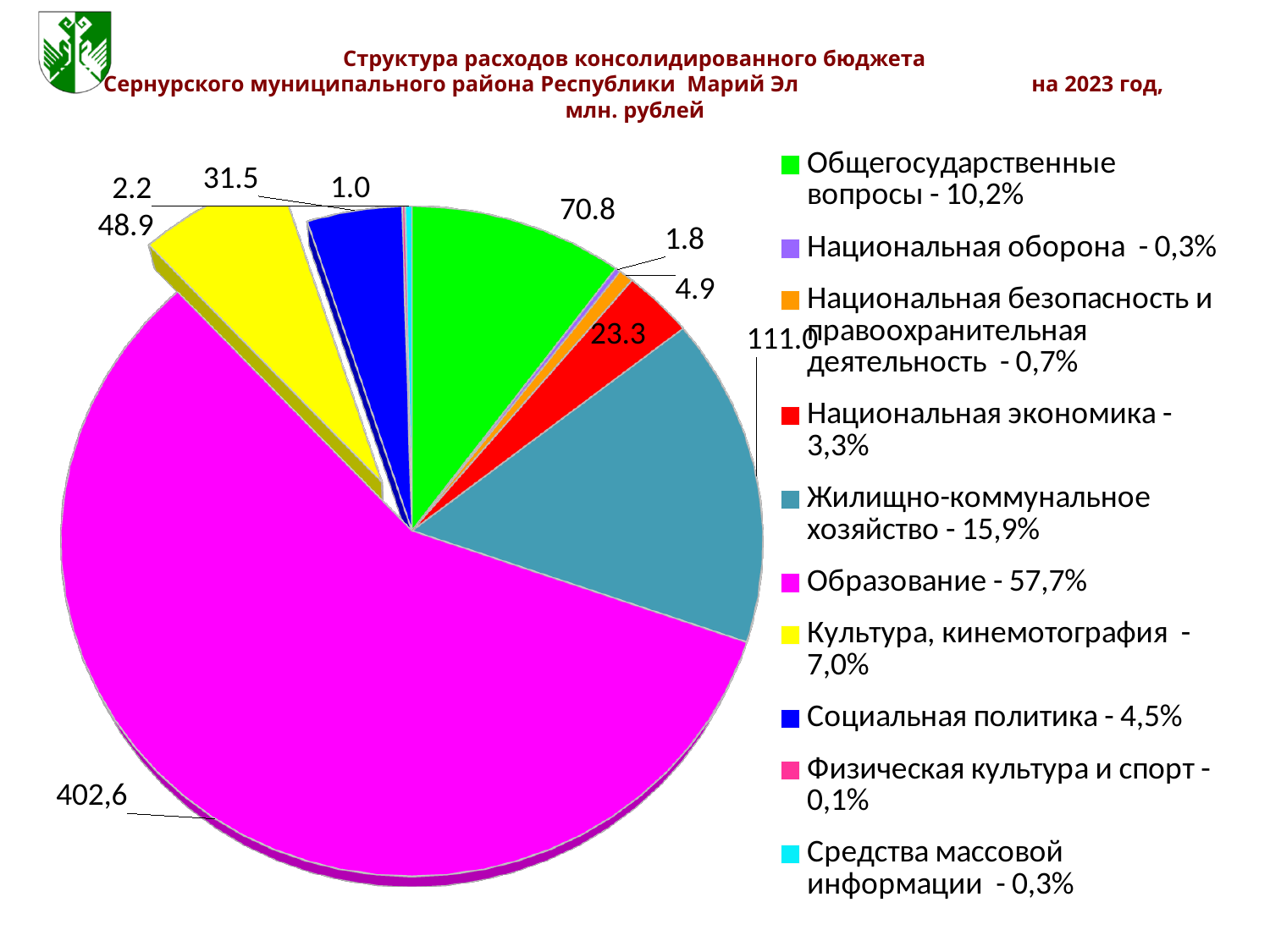
Which category has the largest slice of the pie? Образование What is the value shown for Общегосударственные вопросы? 70.8 What is the value shown for Социальная политика? 31.5 What share of the pie does Образование account for, according to the legend? 57,7% What is the value shown for Жилищно-коммунальное хозяйство? 111.0 What is the difference between the values for Культура, кинемотография and Социальная политика? 17.4 How many categories does the legend of the pie chart list? 10 What kind of chart is shown on the slide? pie chart What is the value shown for Образование? 402,6 Which is larger, the value for Жилищно-коммунальное хозяйство or the value for Общегосударственные вопросы? Жилищно-коммунальное хозяйство What is the value shown for Национальная экономика? 23.3 What is the value shown for Культура, кинемотография? 48.9